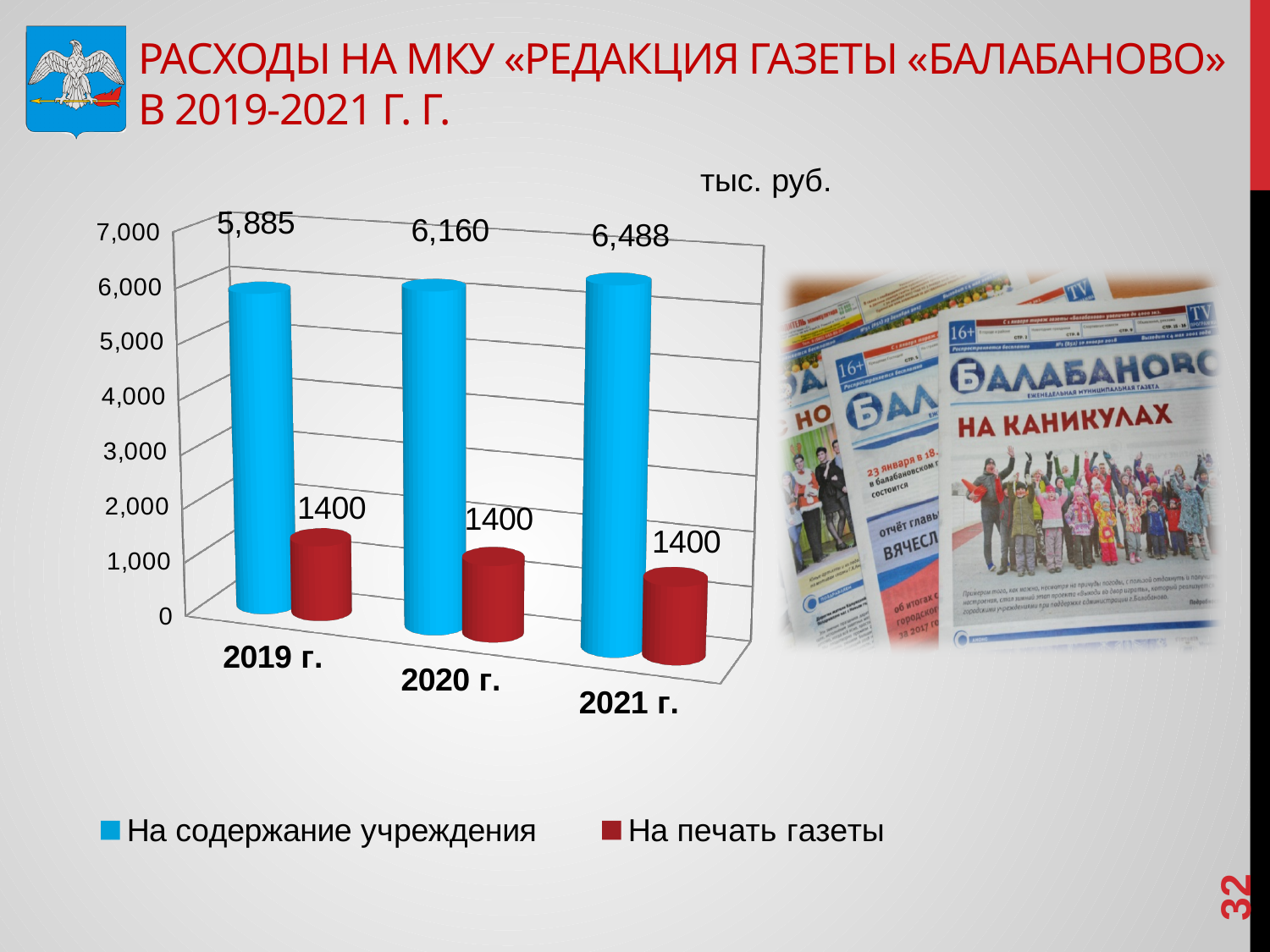
What kind of chart is shown on the slide? Bar chart In which year is the value for «На содержание учреждения» highest? 2021 г. What is the value for «На содержание учреждения» in 2021 г.? 6,488 How many years are shown on the x axis of the chart? 3 Which is larger in 2020 г.: «На содержание учреждения» or «На печать газеты»? На содержание учреждения How many series does the legend list? 2 Do the values for «На содержание учреждения» rise or fall from 2019 г. to 2021 г.? Rise What unit is indicated above the chart? тыс. руб. What is the value for «На печать газеты» in 2020 г.? 1400 In which year is the value for «На содержание учреждения» lowest? 2019 г. What is the difference between the «На содержание учреждения» values for 2021 г. and 2019 г.? 603 What is the value for «На содержание учреждения» in 2019 г.? 5,885